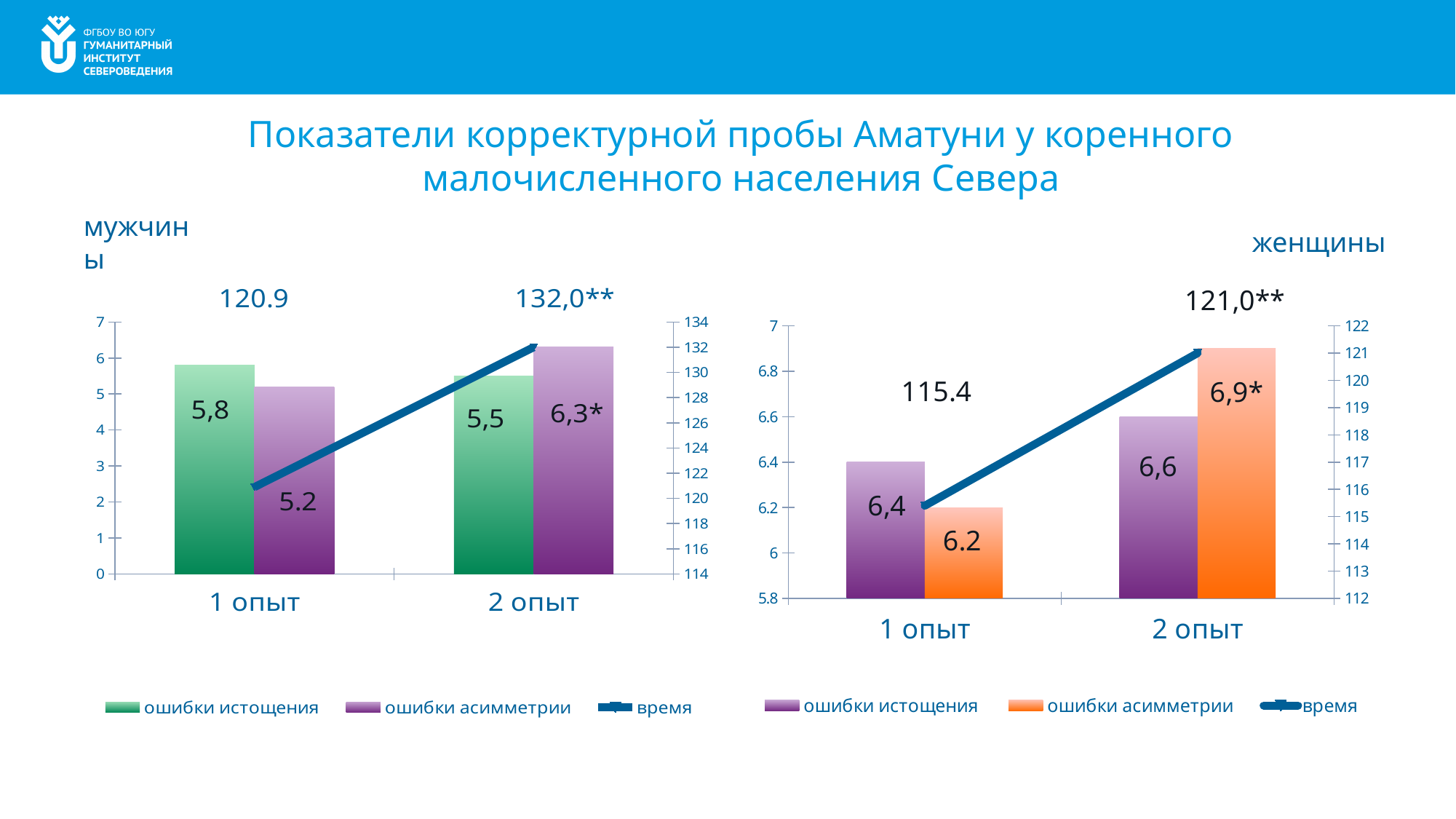
In the 'женщины' chart, what is the value of 'ошибки асимметрии' for '1 опыт'? 6.2 In the 'мужчины' chart, what is the value of 'ошибки асимметрии' for '2 опыт'? 6,3* In the 'женщины' chart, what colour are the 'ошибки асимметрии' bars? orange How many series does the legend of the 'женщины' chart list? 3 In the 'мужчины' chart, what is the value of 'ошибки истощения' for '1 опыт'? 5,8 In the 'женщины' chart, what is the 'время' value for '1 опыт'? 115.4 How many categories are shown on the x axis of the 'мужчины' chart? 2 In the 'мужчины' chart, which is larger for '2 опыт': 'ошибки истощения' or 'ошибки асимметрии'? ошибки асимметрии In the 'мужчины' chart, what is the 'время' value for '1 опыт'? 120.9 In the 'мужчины' chart, what is the 'время' value for '2 опыт'? 132,0** In the 'женщины' chart, does the 'время' line rise or fall from '1 опыт' to '2 опыт'? rise In the 'женщины' chart, what is the value of 'ошибки истощения' for '2 опыт'? 6,6